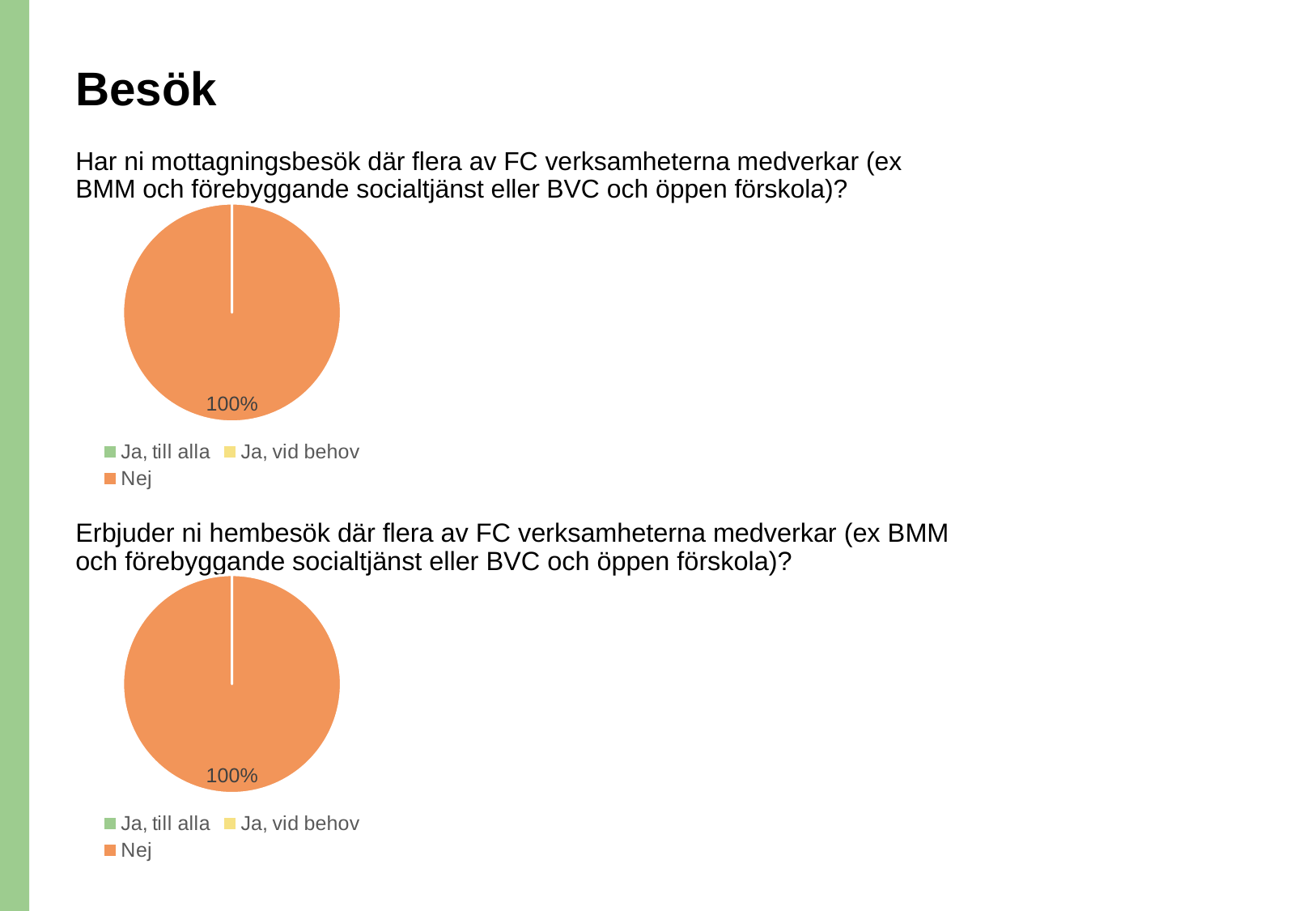
In the bottom pie chart, which is larger: the share for "Nej" or the share for "Ja, vid behov"? Nej What is the title of the slide? Besök In the top pie chart, what share does the "Nej" slice have? 100% What kind of chart is the bottom chart on the slide? Pie chart What kind of chart is the top chart on the slide? Pie chart How many entries does the legend of the bottom pie chart list? 3 In the bottom pie chart, which category has the largest share? Nej How many entries does the legend of the top pie chart list? 3 In the top pie chart, which category has the largest share? Nej In the top pie chart, which is larger: the share for "Nej" or the share for "Ja, till alla"? Nej What colour is the "Nej" slice in the top pie chart? Orange In the bottom pie chart, what share does the "Nej" slice have? 100%